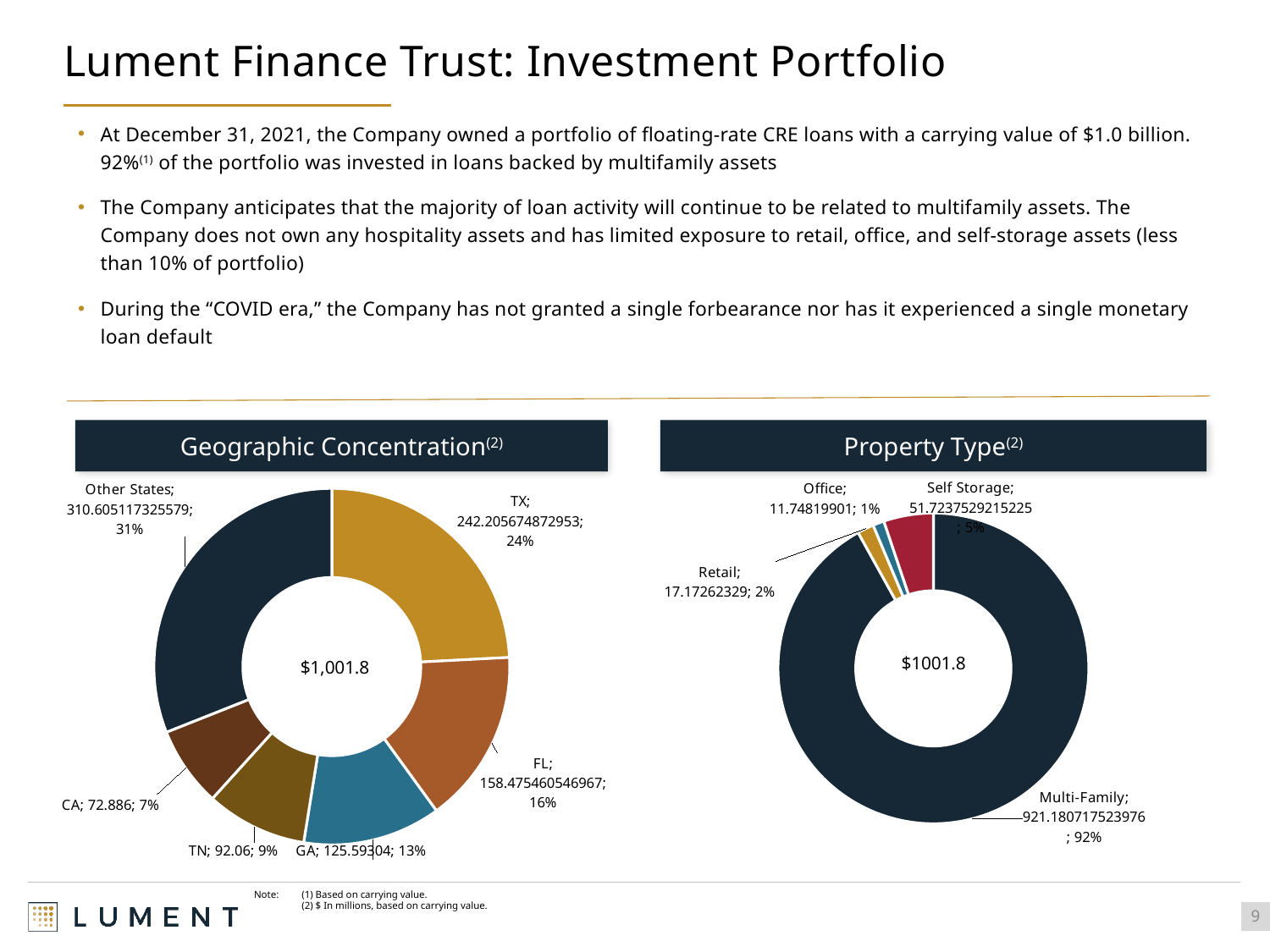
In the Geographic Concentration chart, what percentage share does TX have? 24% In the Property Type chart, which property type has the smallest share? Office What kind of chart is the Property Type chart? Donut (pie) chart In the Geographic Concentration chart, which state has the smallest share? CA In the Geographic Concentration chart, what is the difference in percentage points between FL and GA? 3% In the Geographic Concentration chart, what is the value shown for CA? 72.886 In the Geographic Concentration chart, which is larger, TN or GA? GA In the Property Type chart, what is the value shown for Retail? 17.17262329 In the Property Type chart, what percentage share does Multi-Family have? 92% In the Geographic Concentration chart, which category has the largest share? Other States In the Geographic Concentration chart, how many categories are shown? 6 What total value is shown in the center of the Geographic Concentration chart? $1,001.8